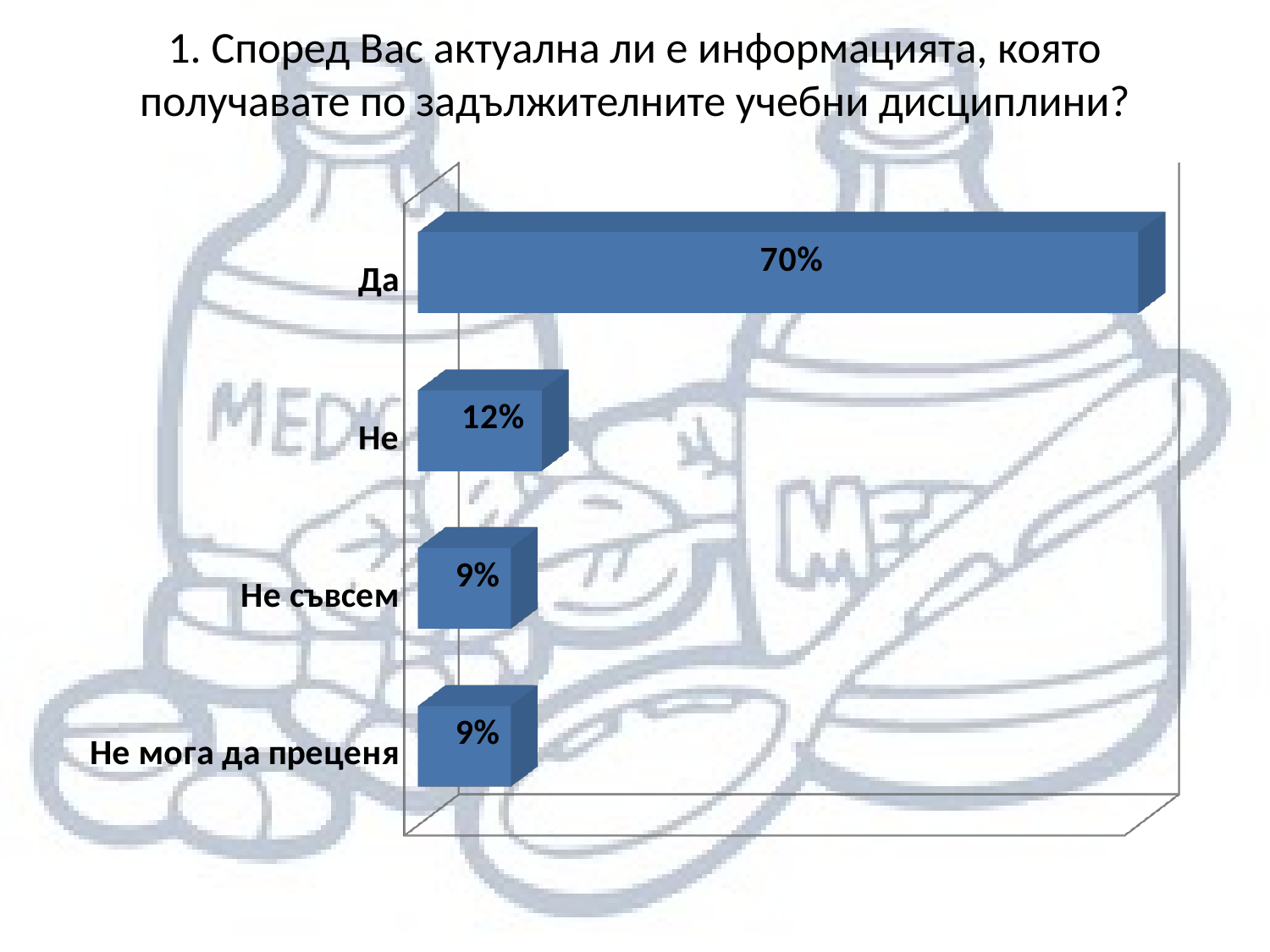
How many categories are shown in the chart? 4 What is the title of the chart on the slide? 1. Според Вас актуална ли е информацията, която получавате по задължителните учебни дисциплини? Which category has the highest value? Да What is the difference between the values for "Не" and "Не съвсем"? 3% What is the value for "Да"? 70% What is the value for "Не"? 12% What is the value for "Не съвсем"? 9% Which is larger, the value for "Не" or the value for "Не съвсем"? Не What is the difference between the values for "Да" and "Не"? 58% What is the value for "Не мога да преценя"? 9% Which two categories have the same value? Не съвсем and Не мога да преценя What kind of chart is shown on the slide? Bar chart